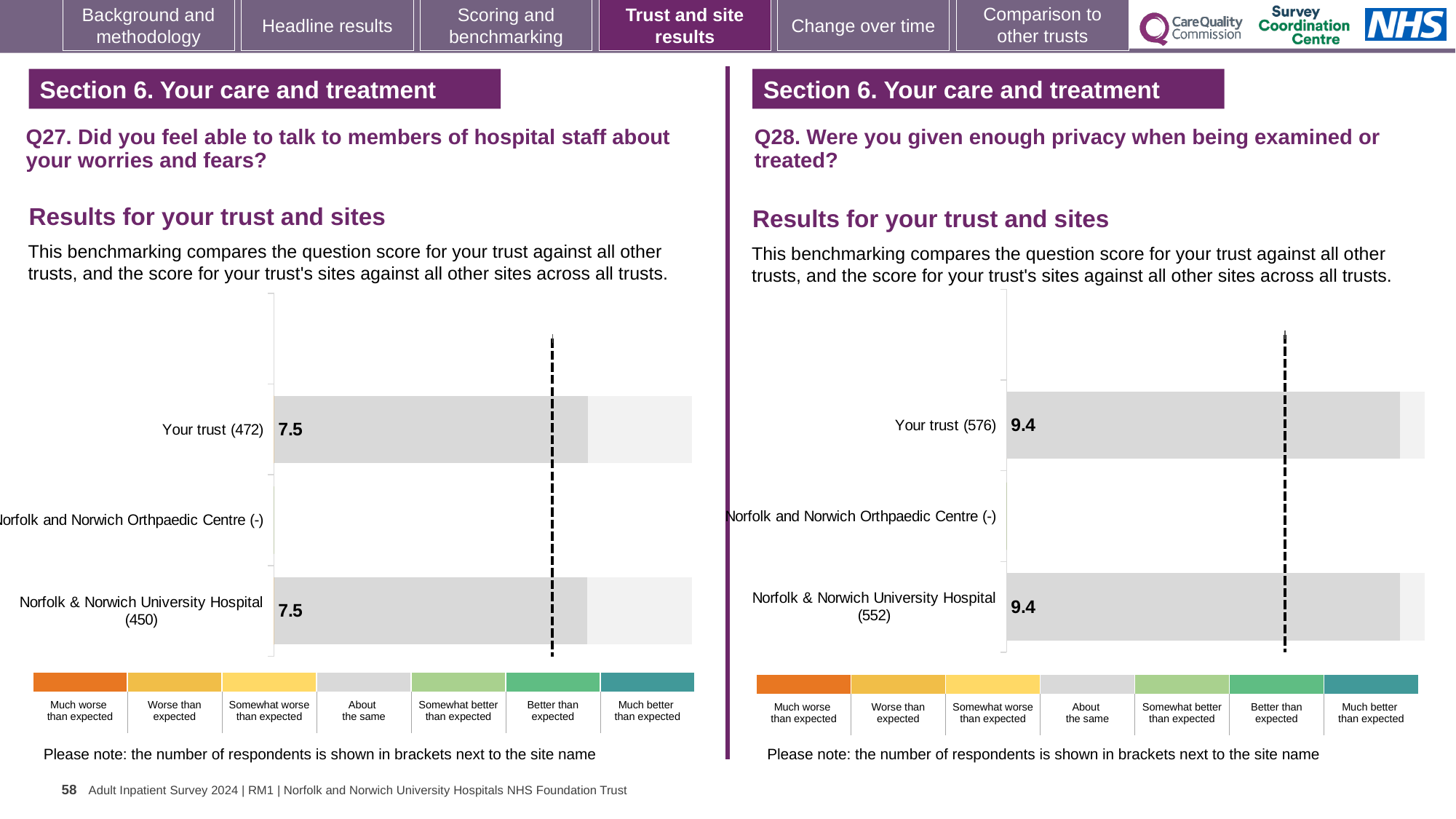
On the Q28 chart (right), what is the difference between the score for Your trust and the score for Norfolk & Norwich University Hospital? 0 On the Q27 chart (left), which category has no bar plotted? Norfolk and Norwich Orthpaedic Centre (-) On the Q27 chart (left), how many respondents are shown in brackets for Your trust? 472 On the Q28 chart (right), how many respondents are shown in brackets for Norfolk & Norwich University Hospital? 552 On the Q27 chart (left), what is the score for Norfolk & Norwich University Hospital? 7.5 How many benchmark bands are shown in the colour key below the Q28 chart (right)? 7 On the Q28 chart (right), what is the score for Norfolk & Norwich University Hospital? 9.4 On the Q27 chart (left), what is the score for Your trust? 7.5 On the Q27 chart (left), what is the difference between the score for Your trust and the score for Norfolk & Norwich University Hospital? 0 On the Q27 chart (left), how many categories are listed on the vertical axis? 3 On the Q28 chart (right), what is the score for Your trust? 9.4 What kind of chart is used on the Q28 chart (right)? Bar chart